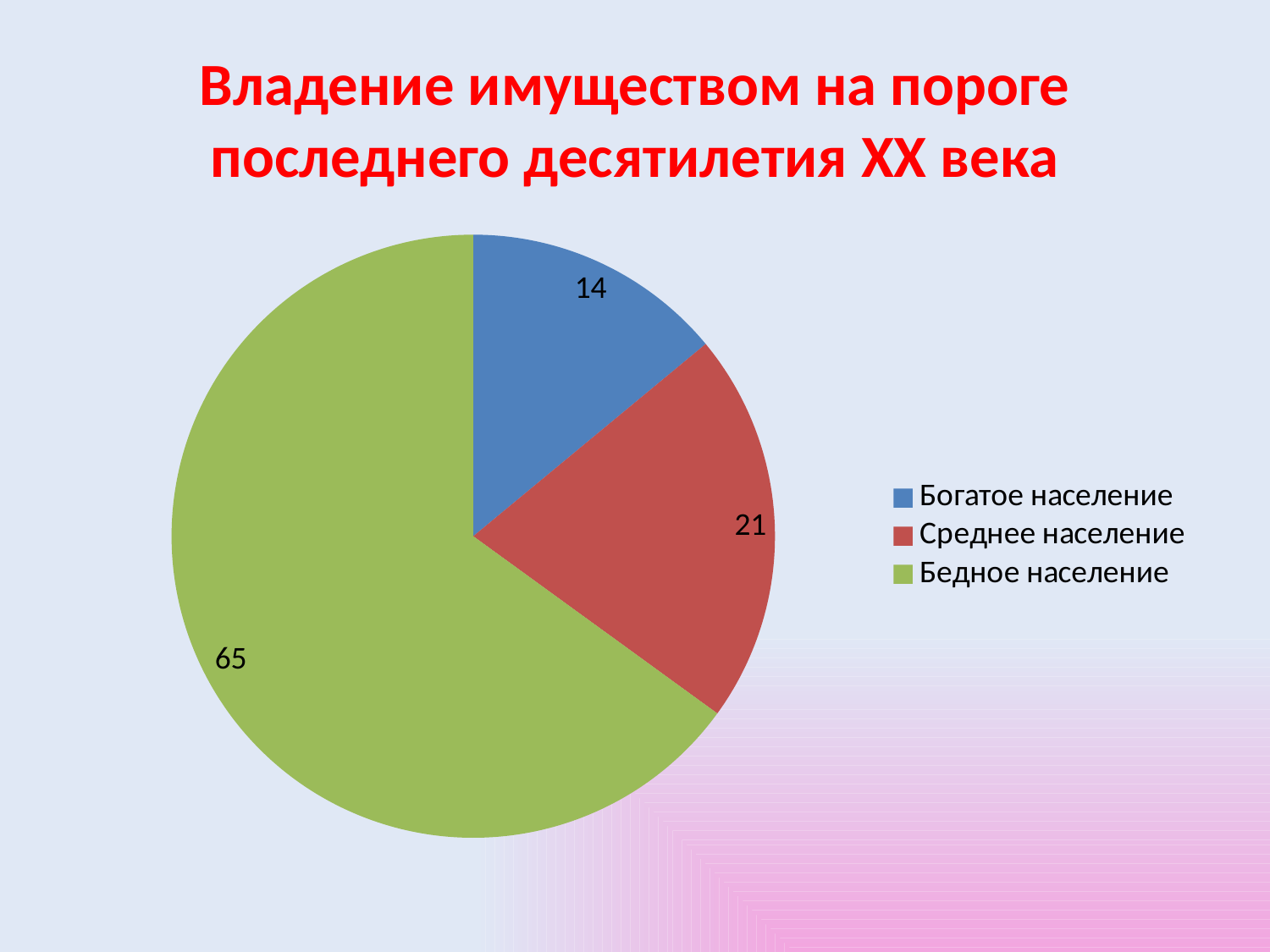
Which category has the smallest slice? Богатое население Which is larger, the value for Среднее население or Богатое население? Среднее население How many slices does the pie chart have? 3 What is the value for Среднее население? 21 What is the difference between the values for Бедное население and Среднее население? 44 How many entries does the legend list? 3 What is the value for Бедное население? 65 What colour is the slice for Бедное население? green Which category has the largest slice? Бедное население What is the difference between the values for Среднее население and Богатое население? 7 What is the value for Богатое население? 14 What type of chart is shown on the slide? pie chart